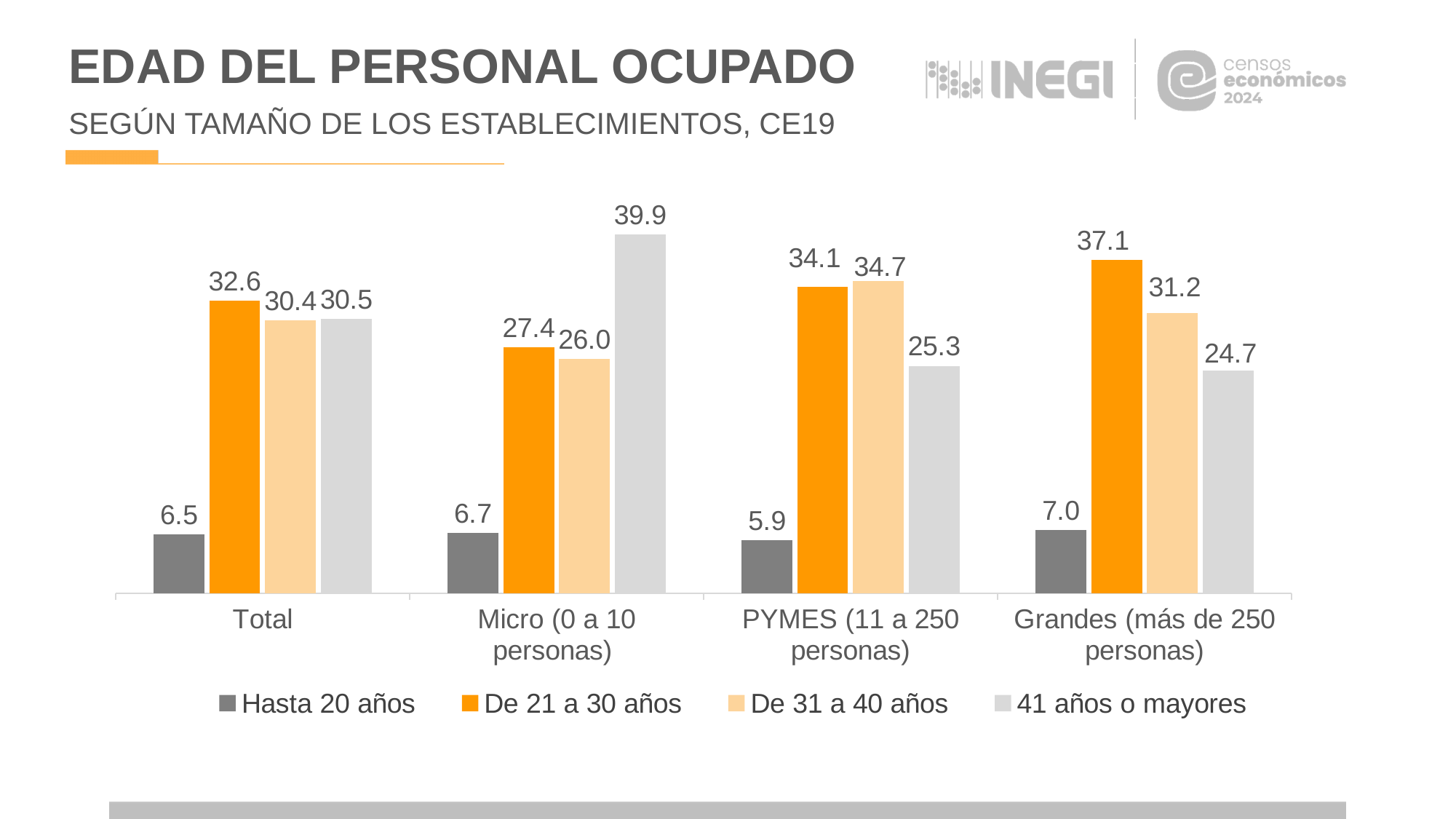
How many categories are shown on the x axis? 4 What is the value for 'De 31 a 40 años' in the Grandes (más de 250 personas) category? 31.2 What is the value for 'Hasta 20 años' in the PYMES (11 a 250 personas) category? 5.9 What kind of chart is shown on the slide? Bar chart What is the difference between 'De 21 a 30 años' and '41 años o mayores' in the Grandes (más de 250 personas) category? 12.4 Which series is shown in dark grey in the legend? Hasta 20 años Which category has the highest value for '41 años o mayores'? Micro (0 a 10 personas) What is the value for '41 años o mayores' in the Micro (0 a 10 personas) category? 39.9 How many series does the legend list? 4 What is the value for 'De 21 a 30 años' in the Total category? 32.6 Which category has the lowest value for 'Hasta 20 años'? PYMES (11 a 250 personas) In the Micro (0 a 10 personas) category, which is larger: 'De 21 a 30 años' or '41 años o mayores'? 41 años o mayores